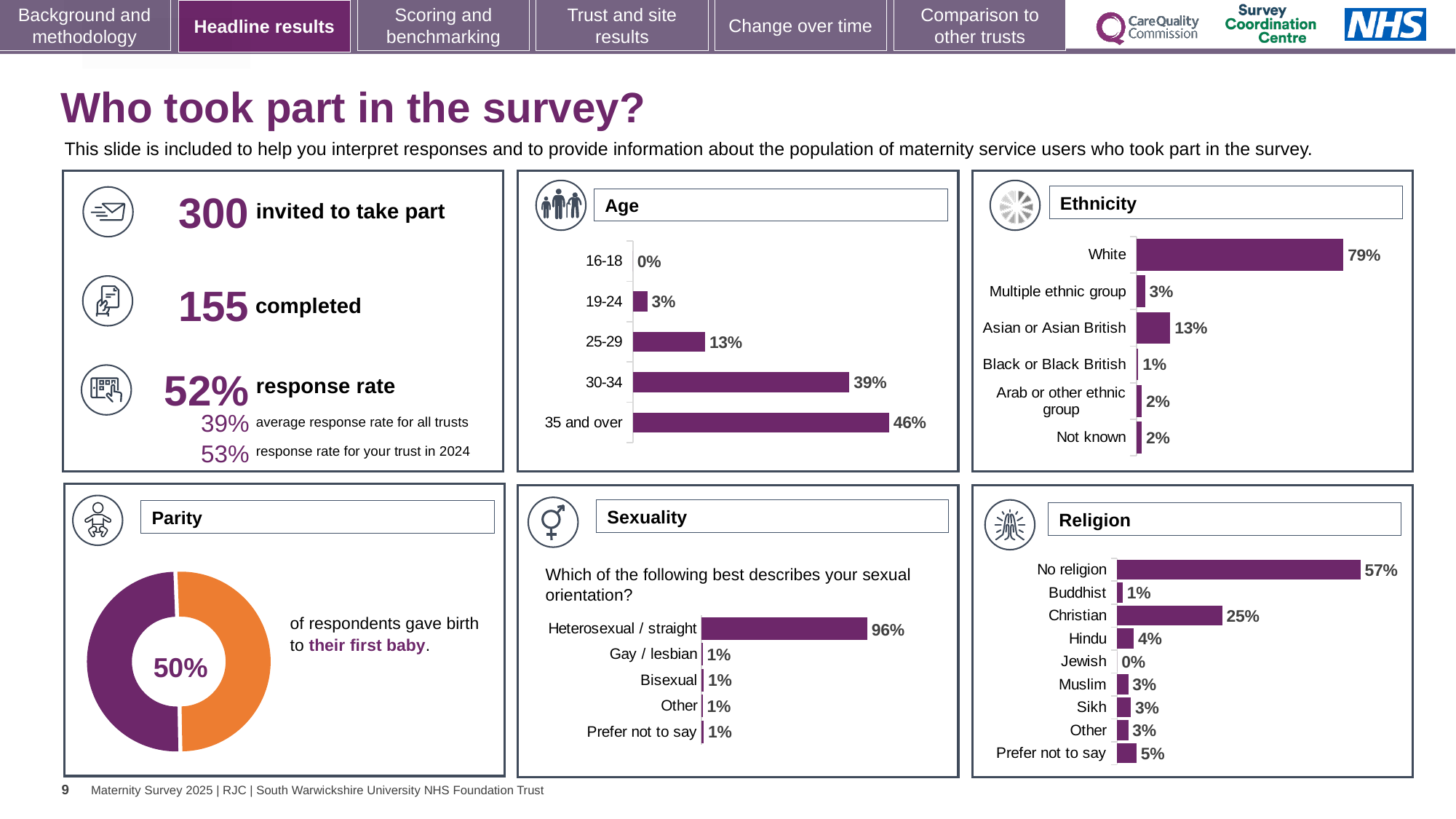
In the Ethnicity chart, what percentage of respondents were Asian or Asian British? 13% In the Ethnicity chart, which category has the lowest percentage? Black or Black British In the Religion chart, which category has the highest percentage? No religion In the Ethnicity chart, is the value for White greater or less than the value for Multiple ethnic group? Greater How many categories are shown in the Religion chart? 9 In the Age chart, what is the difference between the 30-34 and 25-29 percentages? 26% In the Sexuality chart, what percentage of respondents answered Heterosexual / straight? 96% In the Age chart, what percentage of respondents were aged 35 and over? 46% How many age categories are shown in the Age chart? 5 In the Age chart, which age group has the highest percentage? 35 and over What kind of chart is the Parity chart? Pie chart (doughnut) In the Religion chart, what percentage of respondents were Christian? 25%